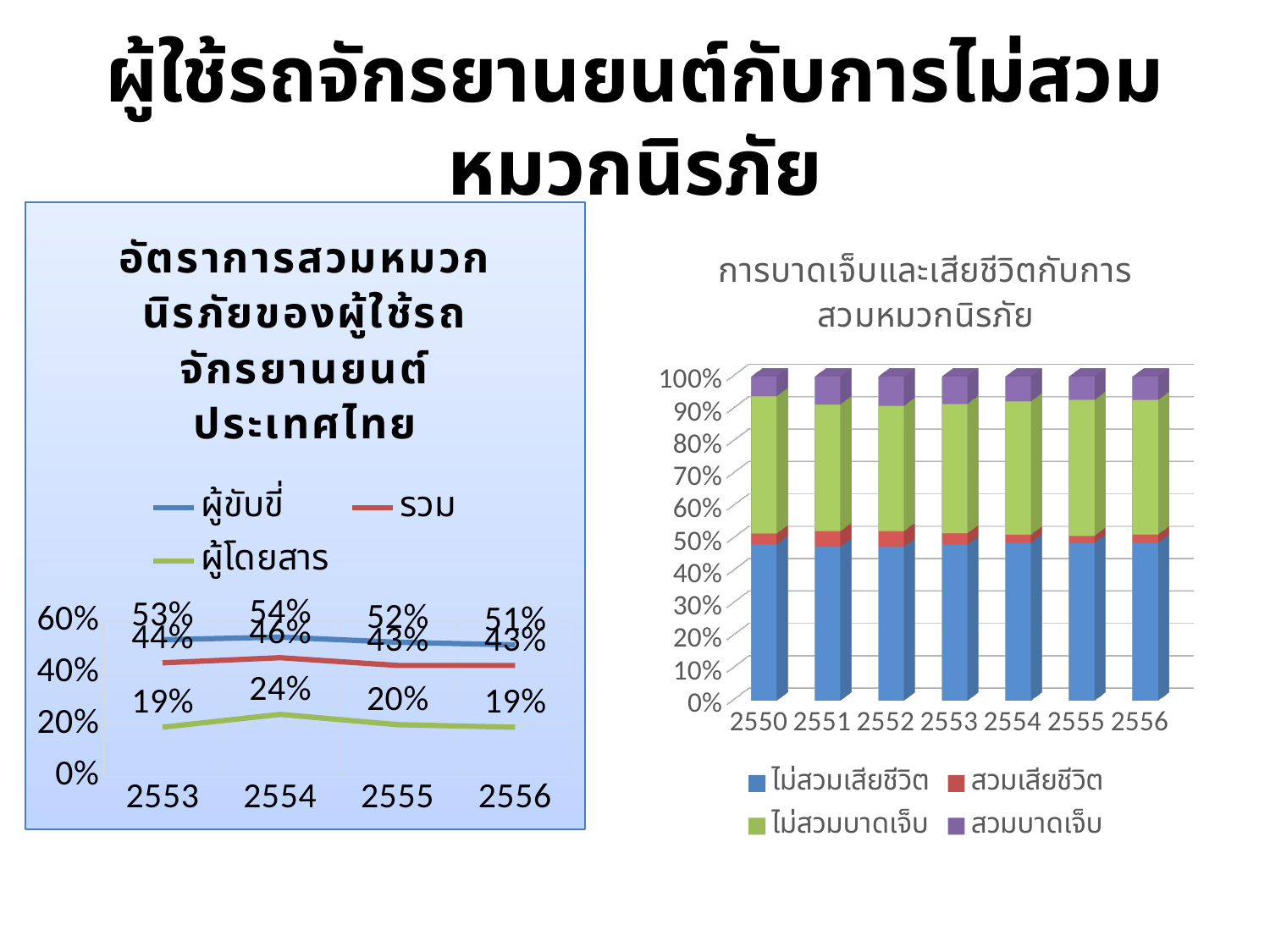
In the left chart (อัตราการสวมหมวกนิรภัยของผู้ใช้รถจักรยานยนต์ประเทศไทย), what is the value for ผู้ขับขี่ in 2554? 54% In the left chart (อัตราการสวมหมวกนิรภัยของผู้ใช้รถจักรยานยนต์ประเทศไทย), in which year is the ผู้โดยสาร value highest? 2554 In the left chart (อัตราการสวมหมวกนิรภัยของผู้ใช้รถจักรยานยนต์ประเทศไทย), what is the difference between the ผู้ขับขี่ and ผู้โดยสาร values in 2555? 32% In the left chart (อัตราการสวมหมวกนิรภัยของผู้ใช้รถจักรยานยนต์ประเทศไทย), does the ผู้ขับขี่ value rise or fall from 2554 to 2556? fall In the left chart (อัตราการสวมหมวกนิรภัยของผู้ใช้รถจักรยานยนต์ประเทศไทย), what is the value for ผู้โดยสาร in 2556? 19% In the right chart (การบาดเจ็บและเสียชีวิตกับการสวมหมวกนิรภัย), how many years are shown on the x axis? 7 In the right chart (การบาดเจ็บและเสียชีวิตกับการสวมหมวกนิรภัย), is the ไม่สวมเสียชีวิต value for 2550 greater or less than 40%? greater In the left chart (อัตราการสวมหมวกนิรภัยของผู้ใช้รถจักรยานยนต์ประเทศไทย), in which year is the ผู้ขับขี่ value lowest? 2556 What kind of chart is the right chart (การบาดเจ็บและเสียชีวิตกับการสวมหมวกนิรภัย)? stacked bar chart In the left chart (อัตราการสวมหมวกนิรภัยของผู้ใช้รถจักรยานยนต์ประเทศไทย), which is larger in 2554: รวม or ผู้โดยสาร? รวม In the left chart (อัตราการสวมหมวกนิรภัยของผู้ใช้รถจักรยานยนต์ประเทศไทย), what is the value for รวม in 2553? 44% In the left chart (อัตราการสวมหมวกนิรภัยของผู้ใช้รถจักรยานยนต์ประเทศไทย), how many series does the legend list? 3